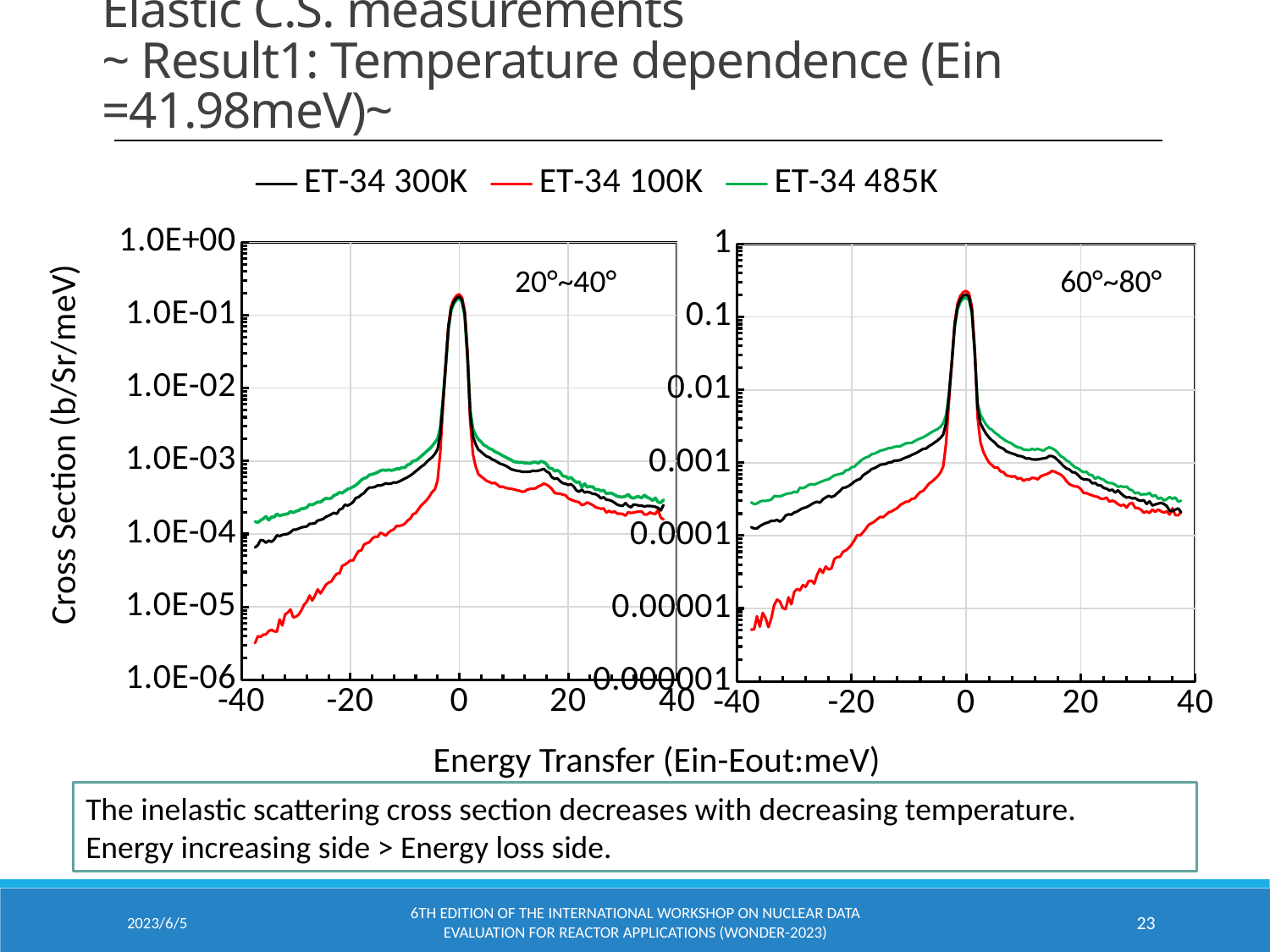
In the right (60°~80°) chart, at an energy transfer of -20, which is larger: ET-34 485K or ET-34 100K? ET-34 485K What is the x-axis title shared by the two charts? Energy Transfer (Ein-Eout:meV) In the left (20°~40°) chart, do the values for ET-34 100K rise or fall as the energy transfer goes from -40 to 0? rise What kind of chart is shown on the left (20°~40°) panel? line chart Which series is drawn in red in the legend? ET-34 100K In the right (60°~80°) chart, is the peak value of ET-34 100K at an energy transfer of 0 greater or less than 0.1? greater How many series does the legend list? 3